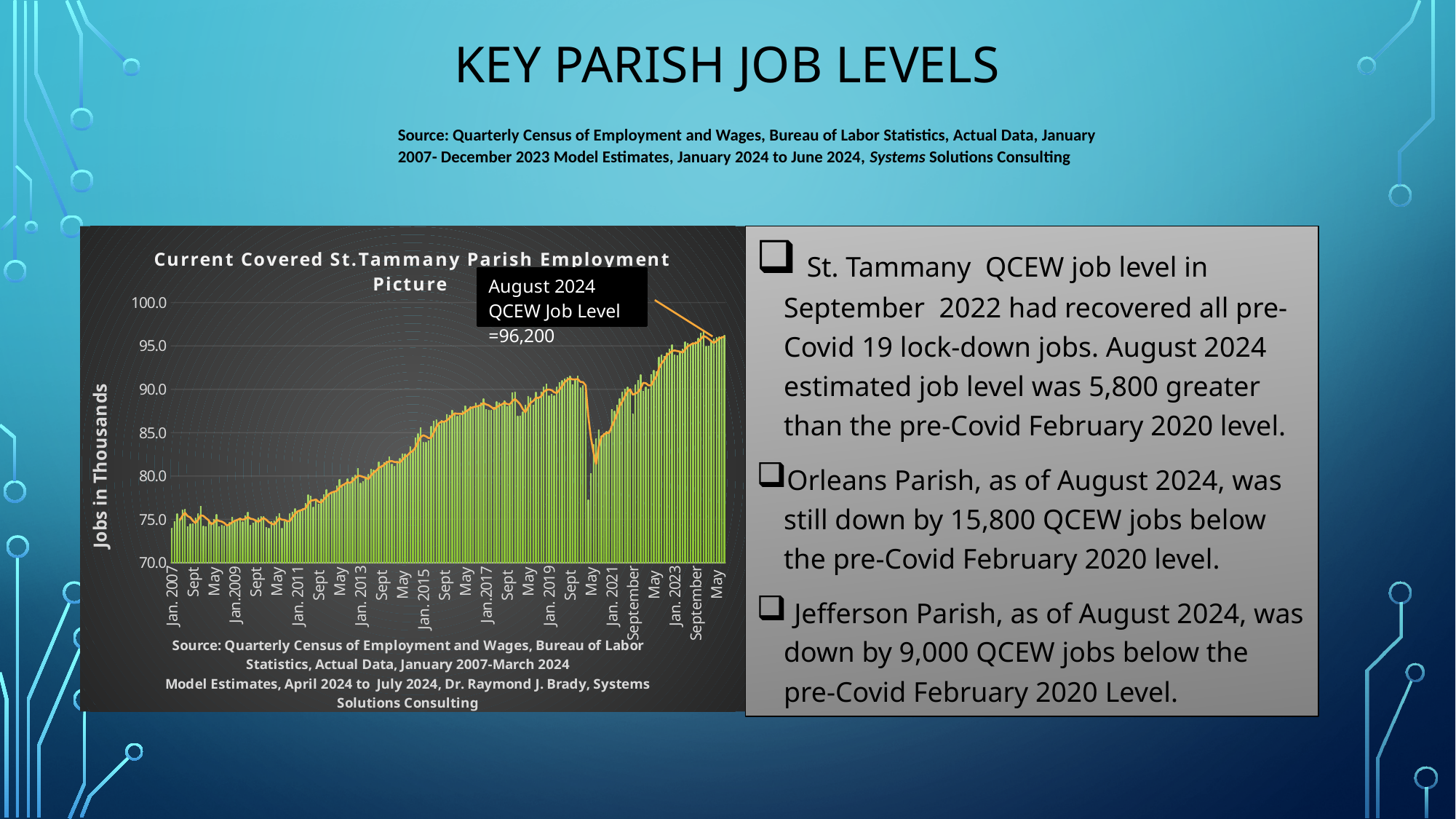
What kind of chart is used to show St. Tammany Parish employment? bar chart Which is larger, the value for Jan. 2007 or the value for Jan. 2023? Jan. 2023 Which is larger, the value for Jan. 2011 or the value for Jan. 2019? Jan. 2019 What is the label on the vertical axis of the chart? Jobs in Thousands Overall, do the job levels rise or fall from Jan. 2007 to 2024 on the chart? rise According to the annotation on the chart, what was the August 2024 QCEW job level? 96,200 What is the title of the chart on the slide? Current Covered St.Tammany Parish Employment Picture Does the highest value on the chart occur near the beginning or near the end of the series? near the end Is the value for Jan. 2023 greater or less than 90.0? greater Is the value at the dip around May 2020 greater or less than 85.0? less Is the value for Jan. 2019 greater or less than 85.0? greater